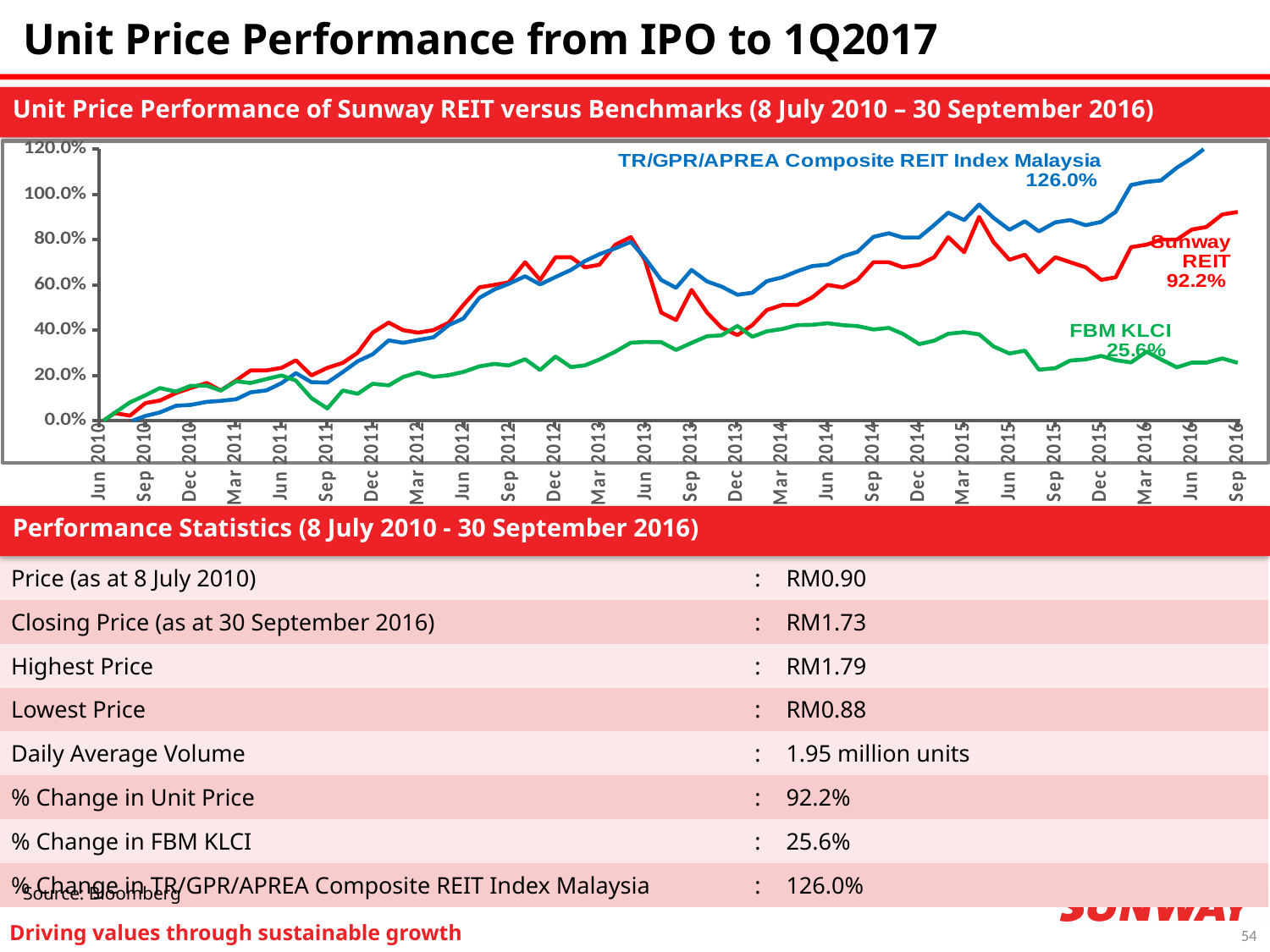
How many series are plotted on the chart? 3 What is the difference between the final values of Sunway REIT and FBM KLCI? 66.6 percentage points Which series has the highest value at the end of the period? TR/GPR/APREA Composite REIT Index Malaysia What is the final value shown for the FBM KLCI line? 25.6% What colour is the Sunway REIT line? Red Is the value for Sunway REIT at Mar 2013 greater or less than 60.0%? greater Which is larger at the end of the period, Sunway REIT or FBM KLCI? Sunway REIT What is the final value shown for the TR/GPR/APREA Composite REIT Index Malaysia line? 126.0% What is the difference between the final values of the TR/GPR/APREA Composite REIT Index Malaysia and Sunway REIT? 33.8 percentage points Which series has the lowest value at the end of the period? FBM KLCI What is the final value shown for the Sunway REIT line? 92.2% What kind of chart is shown on the slide? Line chart